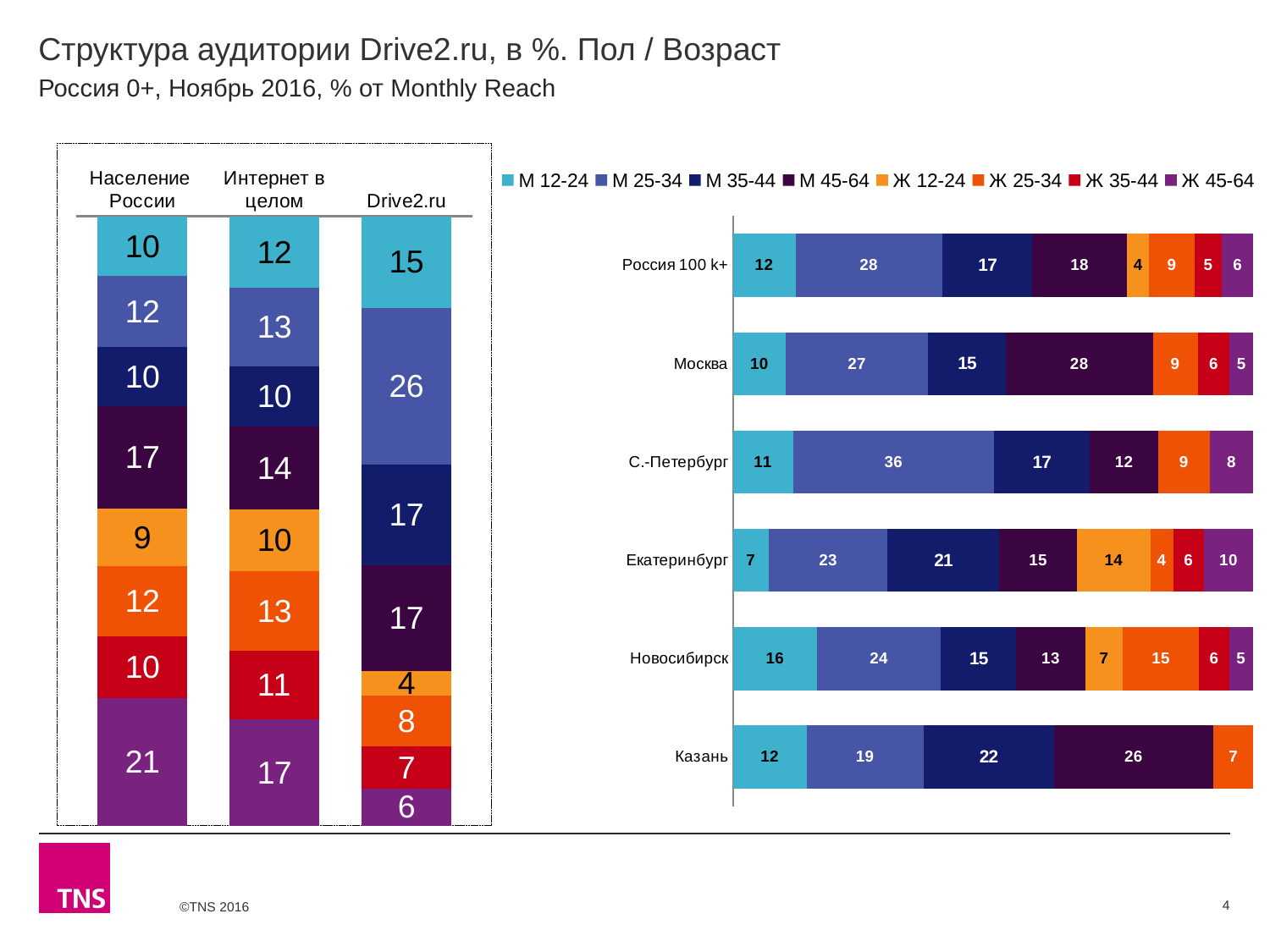
In the right chart, which city has the highest value for М 12-24? Новосибирск How many series does the legend of the right chart list? 8 In the left chart, what is the value for Ж 45-64 in the Население России bar? 21 In the left chart, what is the total of the Drive2.ru bar? 100 In the right chart, which city has the lowest value for М 12-24? Екатеринбург In the left chart, what is the value for М 25-34 in the Drive2.ru bar? 26 In the right chart, what is the value for М 45-64 for Казань? 26 How many cities/regions are shown in the right chart? 6 In the left chart, what is the difference between the Ж 45-64 values for Население России and Drive2.ru? 15 In the right chart, what is the value for М 25-34 for С.-Петербург? 36 In the right chart, which is larger: the М 45-64 value for Москва or for С.-Петербург? Москва What kind of chart is the right chart? Stacked bar chart